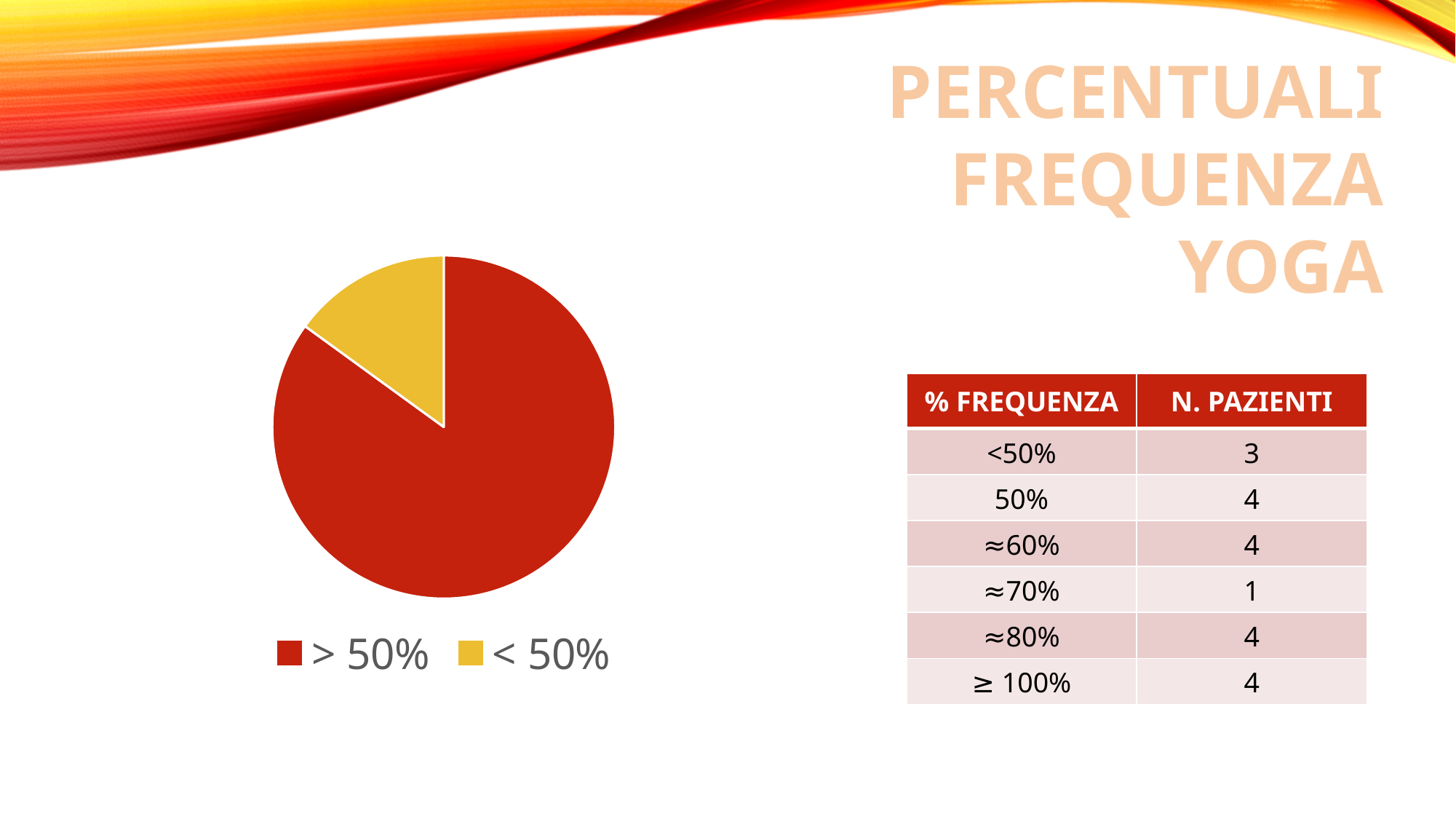
What colour is the "< 50%" slice in the pie chart? yellow How many slices does the pie chart have? 2 What colour is the "> 50%" slice in the pie chart? red Does the "> 50%" slice take up more or less than half of the pie chart? more In the pie chart, which slice is larger: "> 50%" or "< 50%"? > 50% What kind of chart is shown on the slide? pie chart How many entries does the legend of the pie chart list? 2 Which category has the largest slice in the pie chart? > 50% Which category has the smallest slice in the pie chart? < 50%